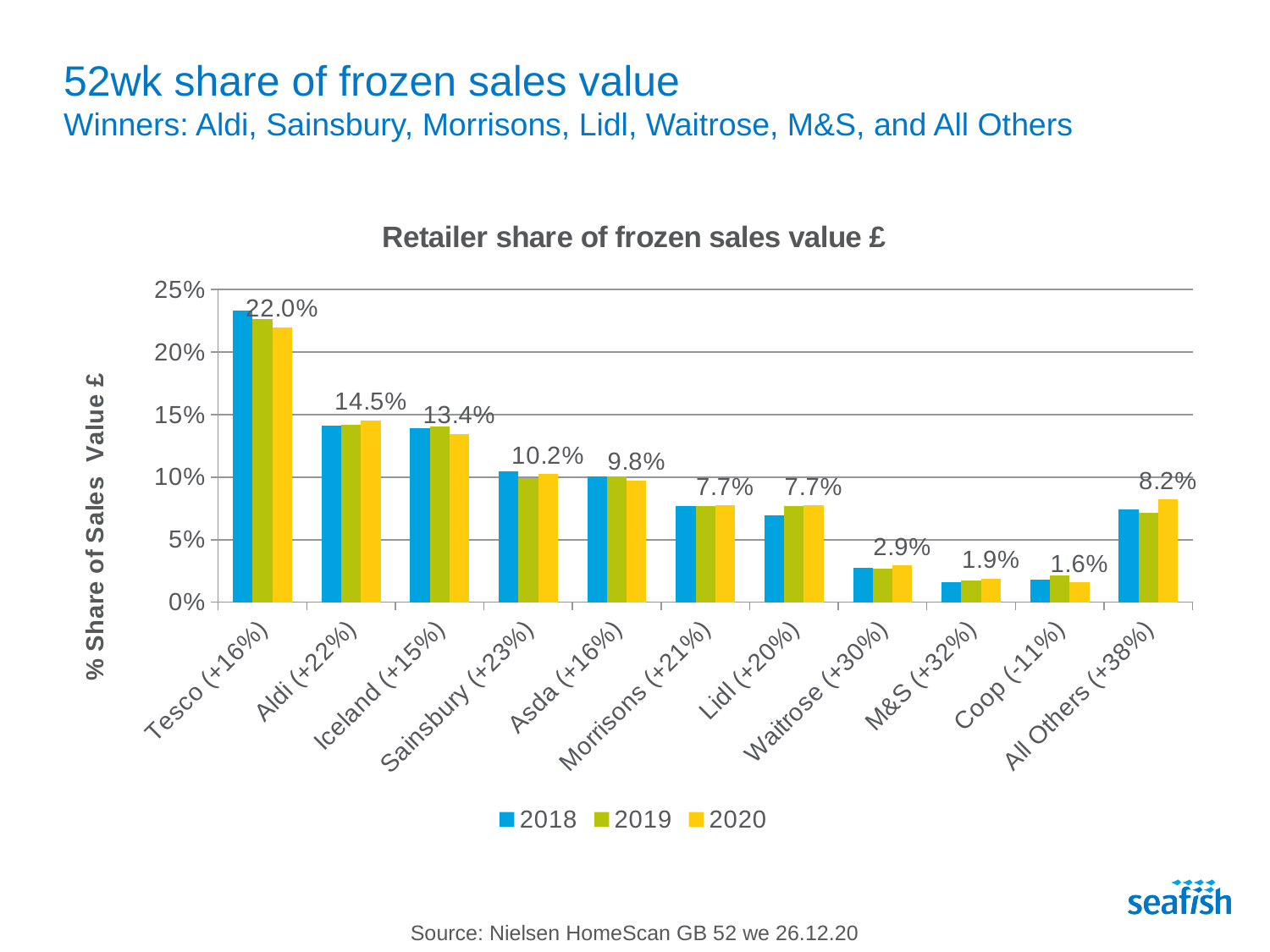
How many series does the legend list? 3 Which has the larger 2020 share of frozen sales value, Asda or All Others? Asda Is the 2018 share of frozen sales value for Tesco greater or less than 20%? greater What is the 2020 share of frozen sales value for Tesco? 22.0% What kind of chart is shown on the slide? Bar chart Which retailer has the lowest 2020 share of frozen sales value? Coop What is the difference between the 2020 shares of Aldi and Iceland? 1.1% What is the 2020 share of frozen sales value for Waitrose? 2.9% How many retailer categories are shown on the x axis? 11 What is the 2020 share of frozen sales value for Aldi? 14.5% Which retailer has the highest 2020 share of frozen sales value? Tesco What is the 2020 share of frozen sales value for All Others? 8.2%